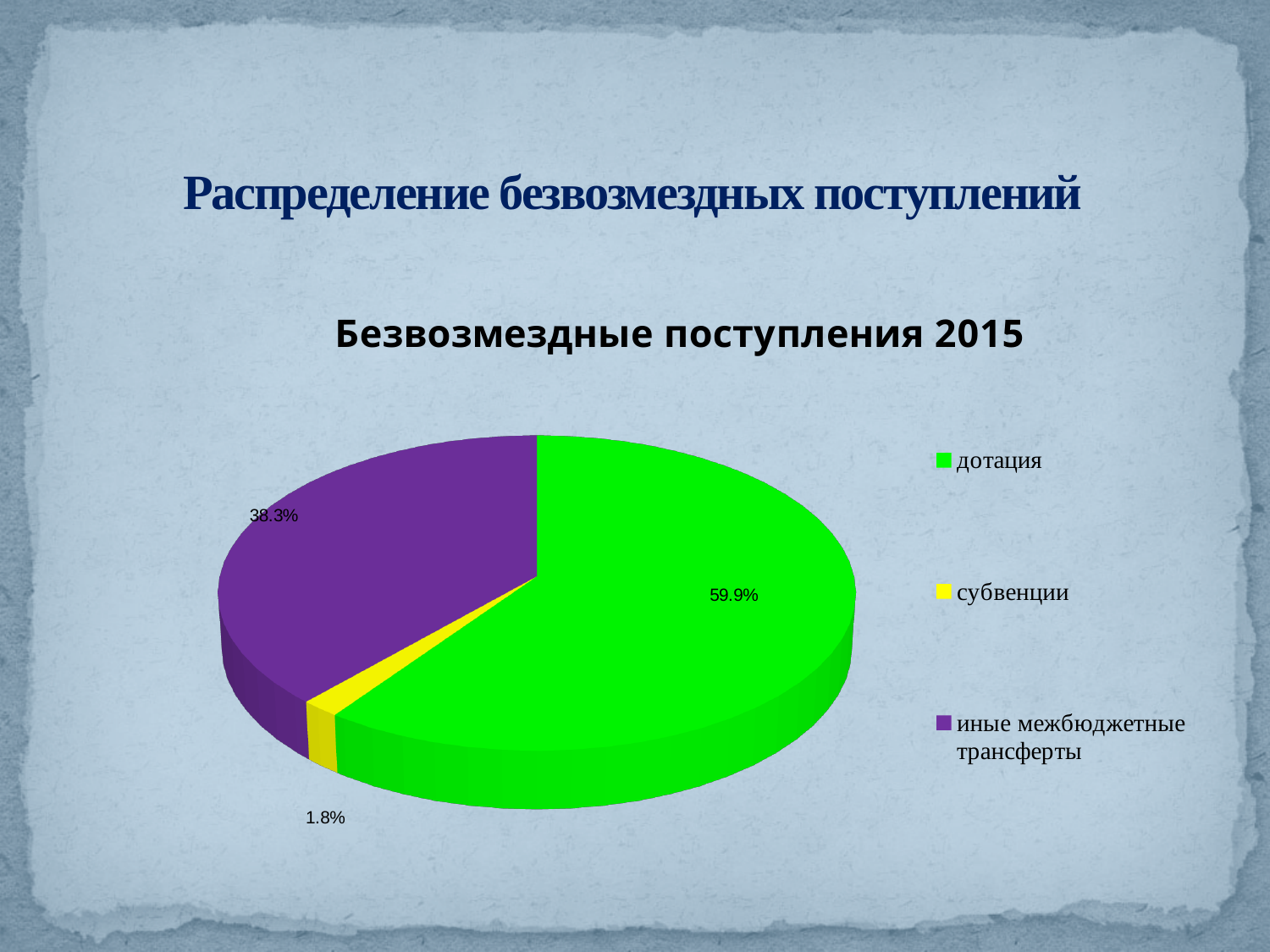
How many entries does the legend list? 3 What is the title of the chart? Безвозмездные поступления 2015 What is the difference in percentage points between дотация and иные межбюджетные трансферты? 21.6 Which category has the smallest slice? субвенции What colour is the slice for субвенции? yellow What share of the pie does дотация take? 59.9% What kind of chart is shown on the slide? pie chart Which category has the largest slice? дотация What share of the pie does субвенции take? 1.8% What share of the pie does иные межбюджетные трансферты take? 38.3% How many slices does the pie chart have? 3 Which is larger, the share for субвенции or the share for иные межбюджетные трансферты? иные межбюджетные трансферты